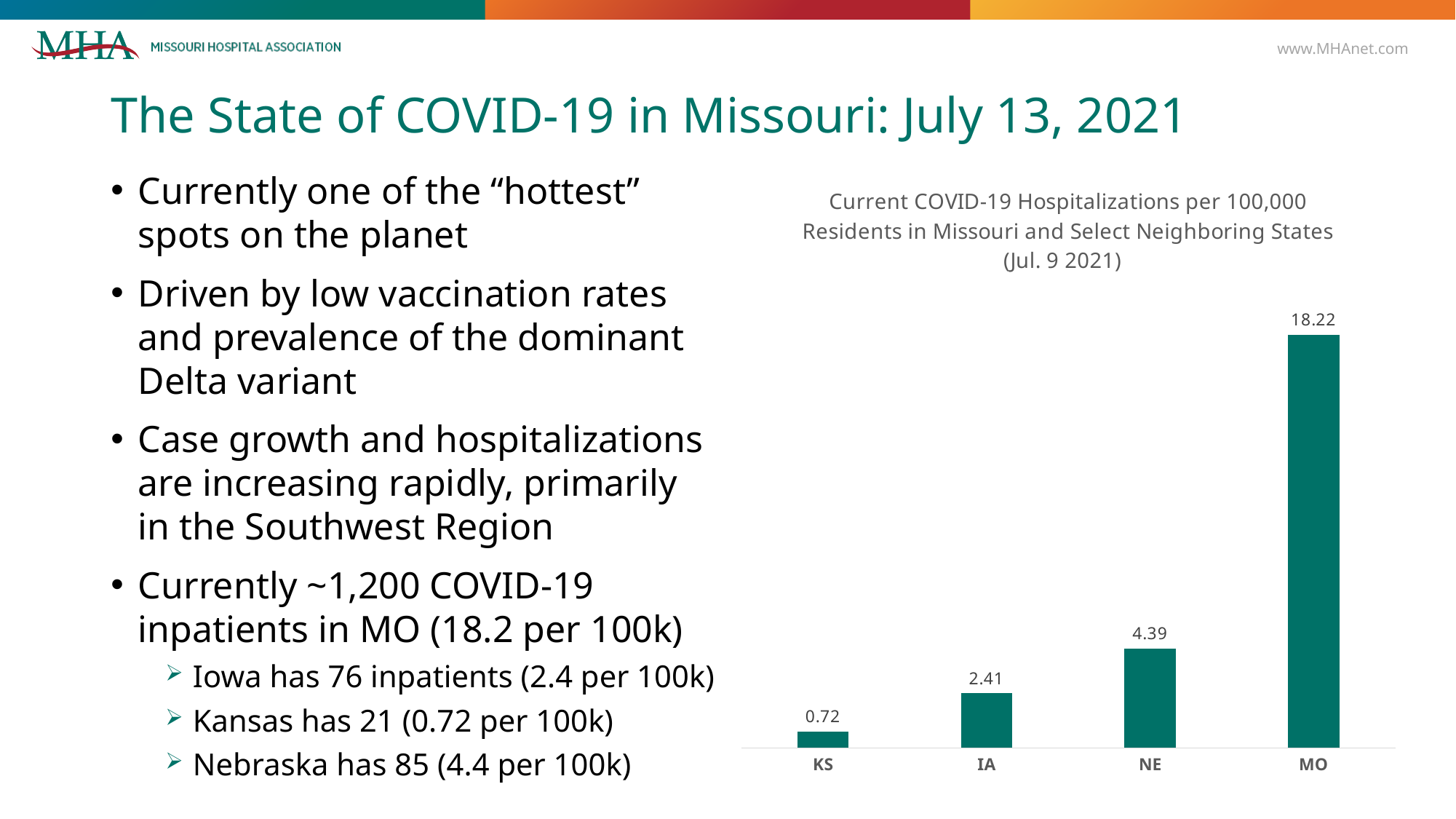
How many states are shown in the chart? 4 What is the value for KS in the chart? 0.72 Which has a larger value, NE or IA? NE Which state has the lowest value in the chart? KS Which state has the highest value in the chart? MO What is the value for MO in the chart? 18.22 What kind of chart is shown on the slide? Bar chart What is the difference between the values for MO and NE? 13.83 What is the difference between the values for IA and KS? 1.69 What is the value for NE in the chart? 4.39 What is the value for IA in the chart? 2.41 What is the title of the chart? Current COVID-19 Hospitalizations per 100,000 Residents in Missouri and Select Neighboring States (Jul. 9 2021)